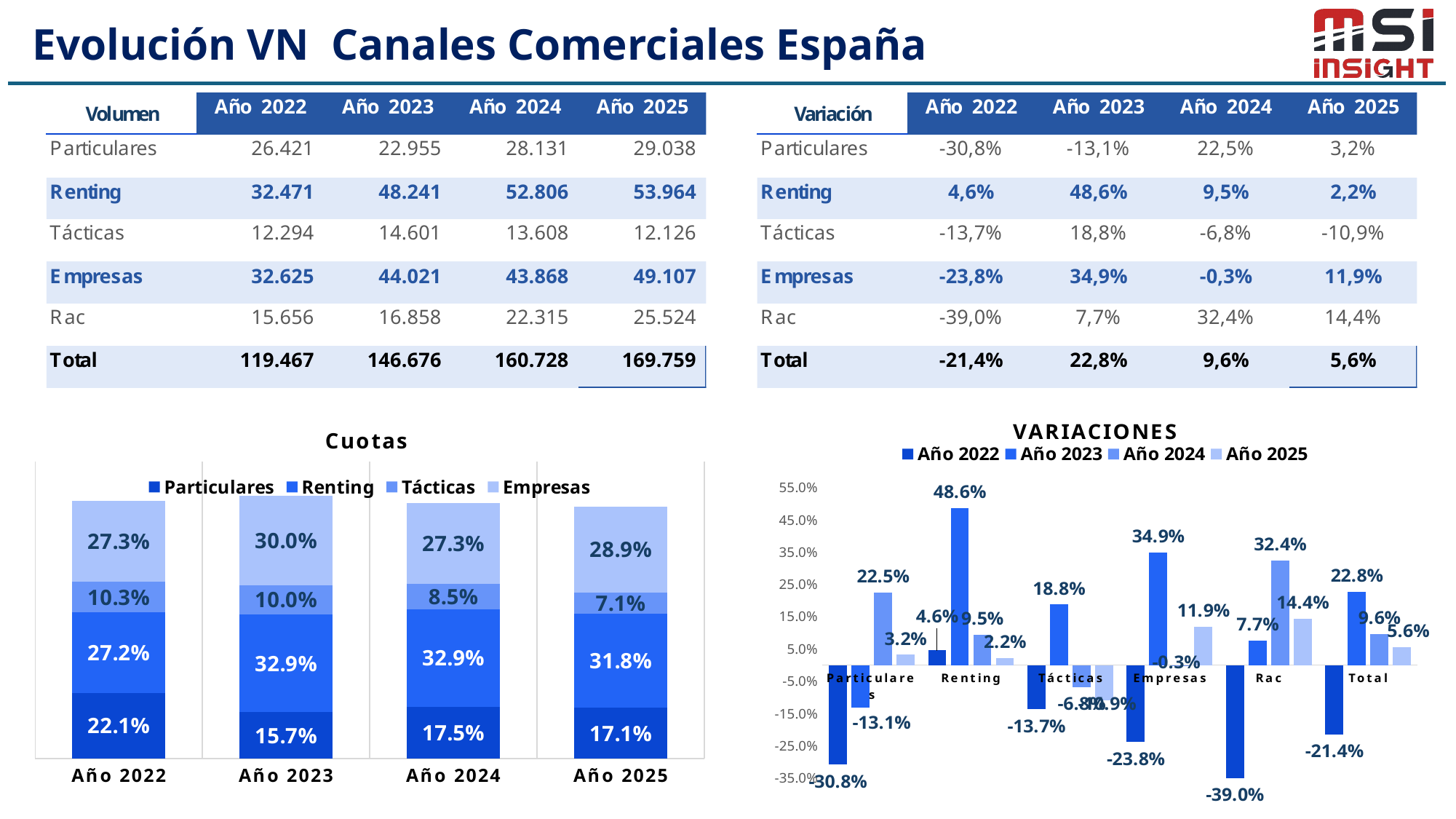
What kind of chart is the 'Cuotas' chart? Stacked bar chart In the 'Cuotas' chart, does the share of Tácticas rise or fall from Año 2022 to Año 2025? Fall How many series does the legend of the 'VARIACIONES' chart list? 4 How many series does the legend of the 'Cuotas' chart list? 4 In the 'VARIACIONES' chart, what is the value for Total in Año 2025? 5.6% In the 'Cuotas' chart, what is the share of Renting in Año 2023? 32.9% In the 'Cuotas' chart, what is the share of Empresas in Año 2025? 28.9% How many categories are shown on the x axis of the 'VARIACIONES' chart? 6 In the 'VARIACIONES' chart, what is the value for Renting in Año 2023? 48.6% In the 'Cuotas' chart, what is the difference between the Particulares share in Año 2022 and in Año 2025? 5.0 percentage points In the 'VARIACIONES' chart, which category and year has the highest value? Renting, Año 2023 (48.6%) In the 'VARIACIONES' chart, which category and year has the lowest value? Rac, Año 2022 (-39.0%)